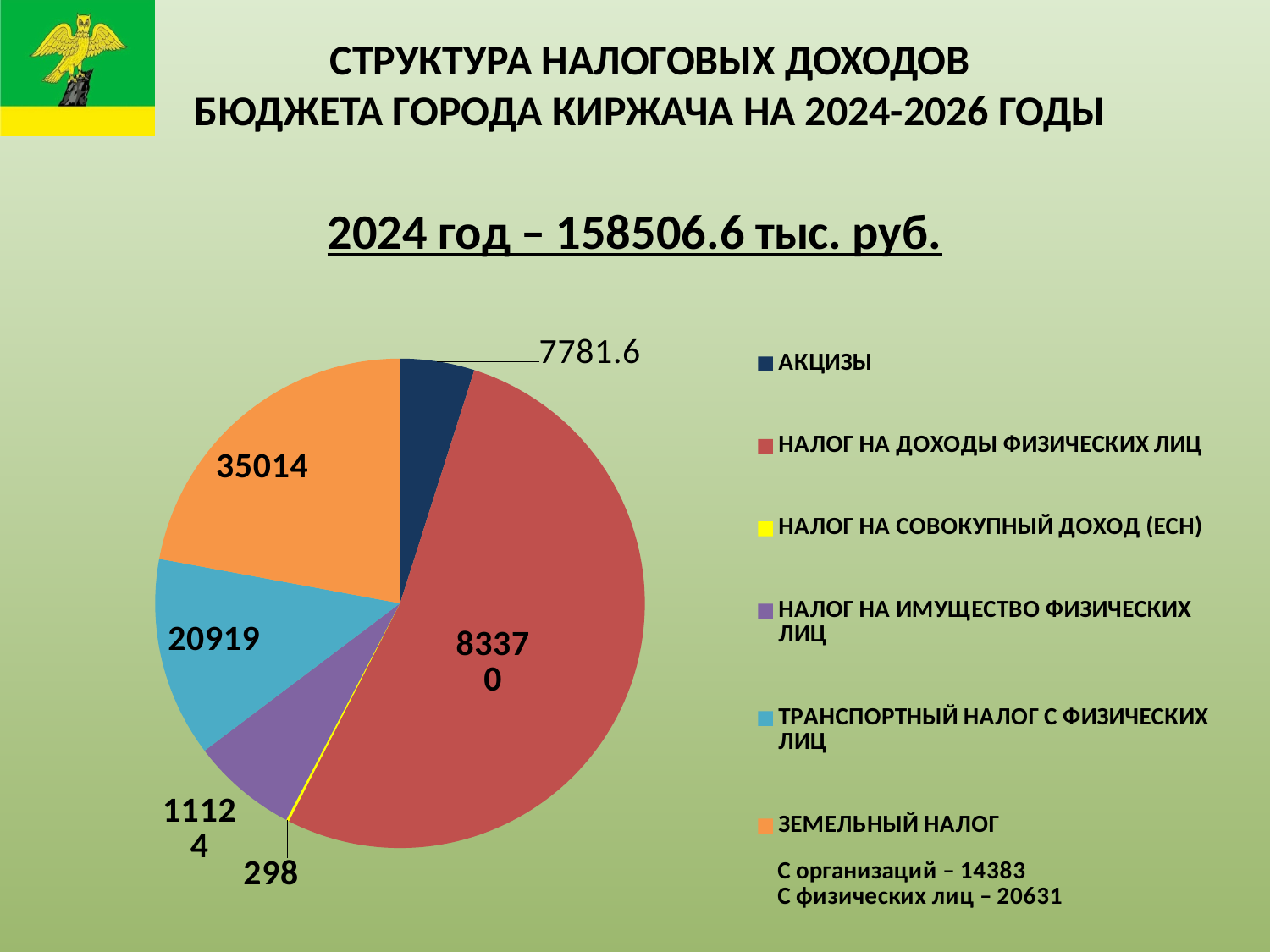
What is the value for АКЦИЗЫ? 7781.6 What type of chart is shown on the slide? pie chart How many entries does the legend list? 6 What colour represents ЗЕМЕЛЬНЫЙ НАЛОГ in the legend? orange Which category has the smallest slice of the pie? НАЛОГ НА СОВОКУПНЫЙ ДОХОД (ЕСН) What is the total of all slices shown for 2024, as stated on the slide? 158506.6 тыс. руб. What is the difference between the values for НАЛОГ НА ДОХОДЫ ФИЗИЧЕСКИХ ЛИЦ and ЗЕМЕЛЬНЫЙ НАЛОГ? 48356 How many slices does the pie chart have? 6 Which is larger: ЗЕМЕЛЬНЫЙ НАЛОГ or ТРАНСПОРТНЫЙ НАЛОГ С ФИЗИЧЕСКИХ ЛИЦ? ЗЕМЕЛЬНЫЙ НАЛОГ Which category has the largest slice of the pie? НАЛОГ НА ДОХОДЫ ФИЗИЧЕСКИХ ЛИЦ What is the value for ТРАНСПОРТНЫЙ НАЛОГ С ФИЗИЧЕСКИХ ЛИЦ? 20919 What is the value for НАЛОГ НА ДОХОДЫ ФИЗИЧЕСКИХ ЛИЦ? 83370